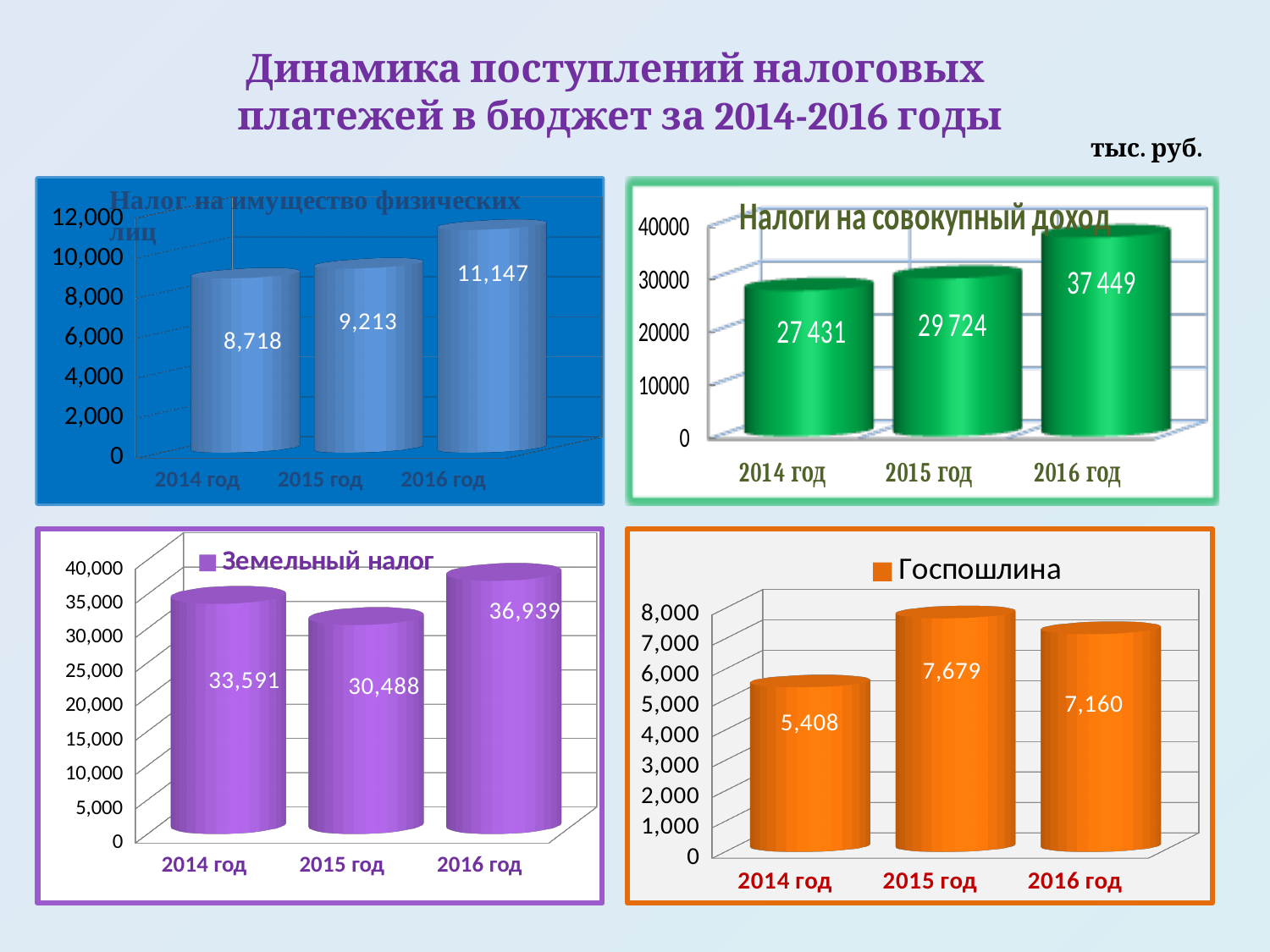
What type of chart is the top-left chart (Налог на имущество физических лиц)? bar chart In the top-right chart (Налоги на совокупный доход), what is the value for 2014 год? 27 431 In the top-left chart (Налог на имущество физических лиц), what is the value for 2015 год? 9,213 In the bottom-left chart (Земельный налог), which year has the lowest value? 2015 год In the top-right chart (Налоги на совокупный доход), what is the difference between the 2016 год and 2015 год values? 7 725 In the bottom-left chart (Земельный налог), what is the value for 2015 год? 30,488 In the bottom-right chart (Госпошлина), what is the value for 2016 год? 7,160 In the bottom-left chart (Земельный налог), what is the difference between the 2016 год and 2014 год values? 3,348 In the top-right chart (Налоги на совокупный доход), do the values rise or fall from 2014 to 2016? rise In the top-left chart (Налог на имущество физических лиц), which year has the highest value? 2016 год How many bars does the bottom-right chart (Госпошлина) have? 3 In the bottom-right chart (Госпошлина), which is larger, the value for 2015 год or 2016 год? 2015 год